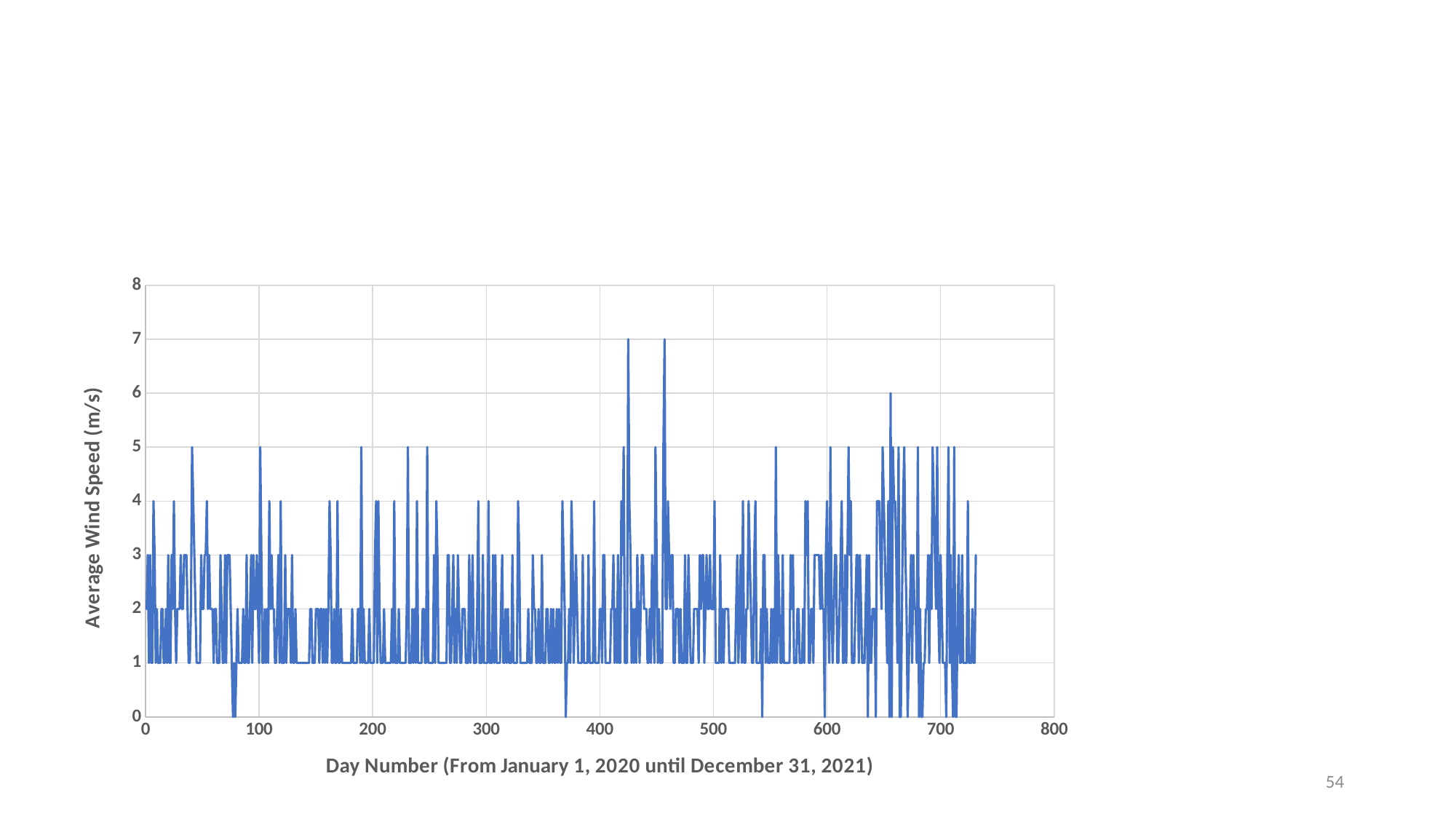
Is the highest value reached by the line greater or less than 8? less What is the label of the horizontal axis? Day Number (From January 1, 2020 until December 31, 2021) What is the lowest average wind speed value the line reaches? 0 What is the label of the vertical axis? Average Wind Speed (m/s) What is the largest tick value shown on the horizontal axis? 800 Is the highest value reached by the line greater or less than 6? greater What kind of chart is shown on the slide? line chart What is the highest average wind speed value the line reaches? 7 What is the largest tick value shown on the vertical axis? 8 How many data series (lines) are plotted on the chart? 1